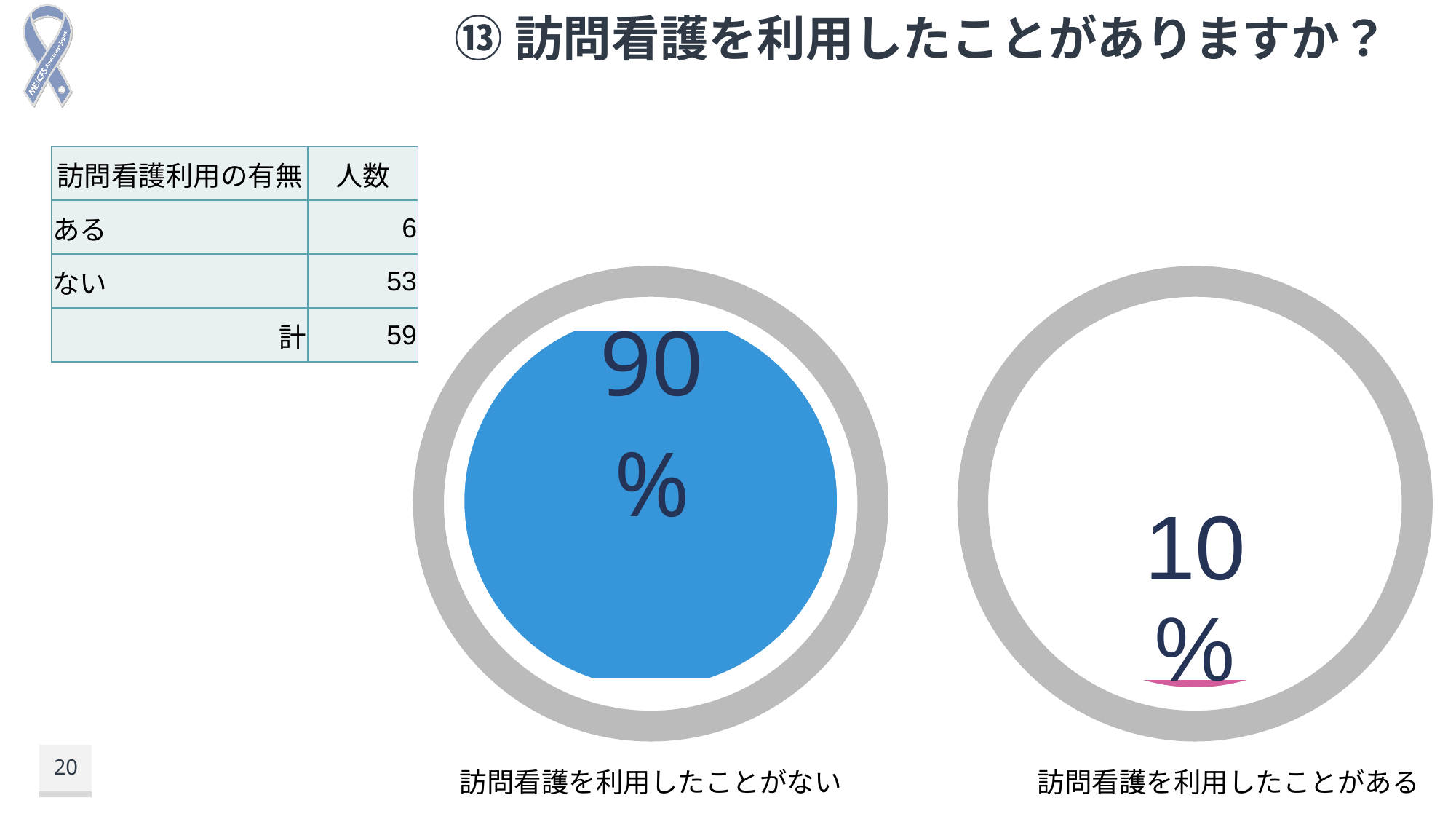
What do the percentages in the left chart and the right chart add up to? 100% What percentage is shown in the left chart labelled 訪問看護を利用したことがない? 90% What is the difference between the percentage in the left chart (90%) and the percentage in the right chart (10%)? 80% Which of the two charts shows the lower percentage, 訪問看護を利用したことがない or 訪問看護を利用したことがある? 訪問看護を利用したことがある Is the value shown in the right chart (訪問看護を利用したことがある) greater or less than 50%? less Which of the two charts shows the higher percentage, 訪問看護を利用したことがない or 訪問看護を利用したことがある? 訪問看護を利用したことがない What percentage is shown in the right chart labelled 訪問看護を利用したことがある? 10% Is the value shown in the left chart (訪問看護を利用したことがない) greater or less than 50%? greater What is the label written below the right chart? 訪問看護を利用したことがある What colour is the filled circle in the left chart? Blue Is the percentage in the left chart (訪問看護を利用したことがない) larger or smaller than the percentage in the right chart (訪問看護を利用したことがある)? larger How many circular charts are shown on the slide? 2